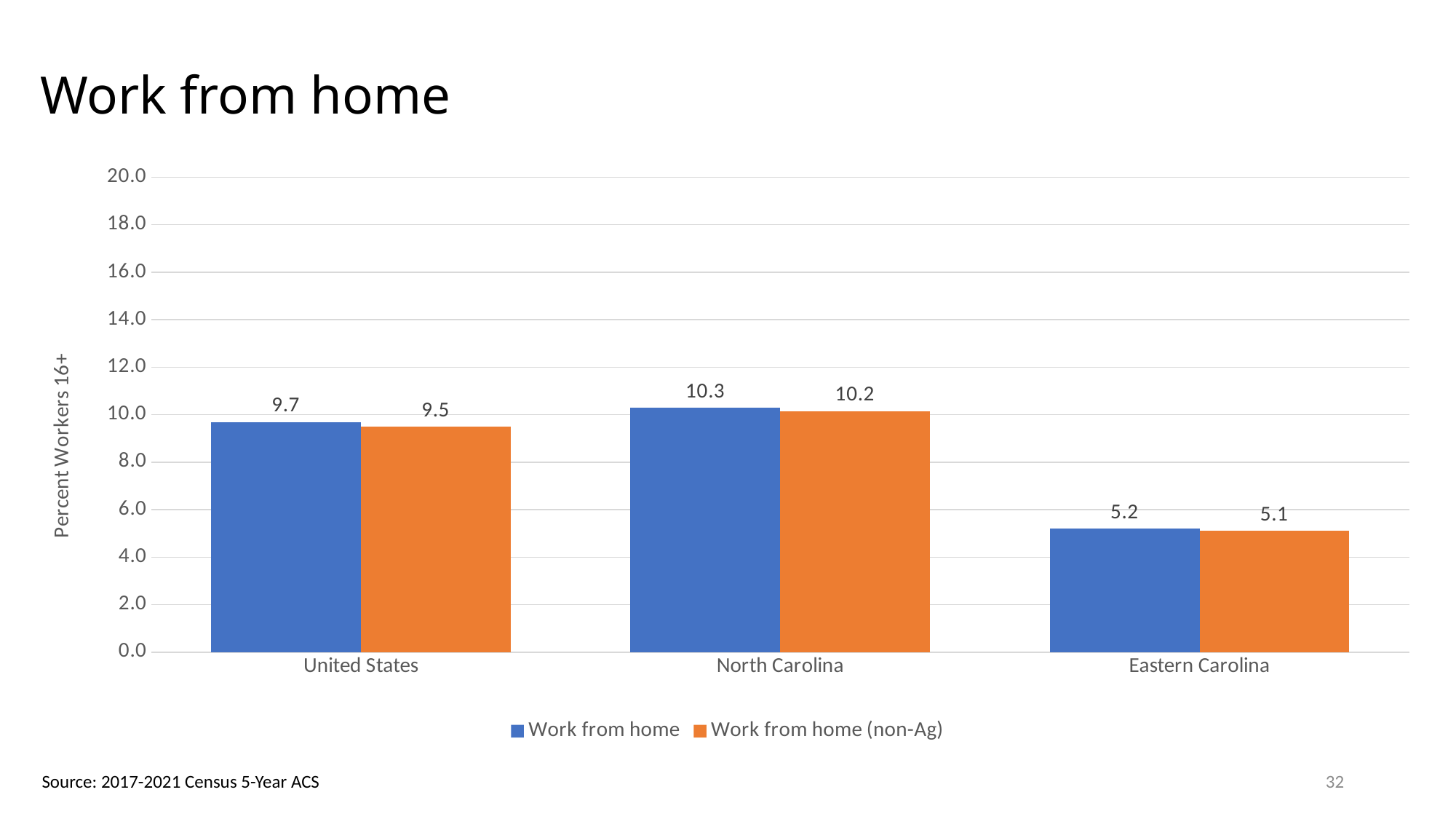
What is the Work from home value for United States? 9.7 Is the Work from home (non-Ag) value for United States greater or less than 8.0? greater Which category has the lowest Work from home (non-Ag) value? Eastern Carolina What kind of chart is shown on the slide? bar chart How many series does the legend list? 2 What is the difference between the Work from home values for North Carolina and Eastern Carolina? 5.1 How many categories are shown on the x axis? 3 Which category has the highest Work from home value? North Carolina Which is larger: the Work from home value for United States or for Eastern Carolina? United States What is the Work from home (non-Ag) value for Eastern Carolina? 5.1 What is the Work from home value for Eastern Carolina? 5.2 What is the Work from home (non-Ag) value for North Carolina? 10.2